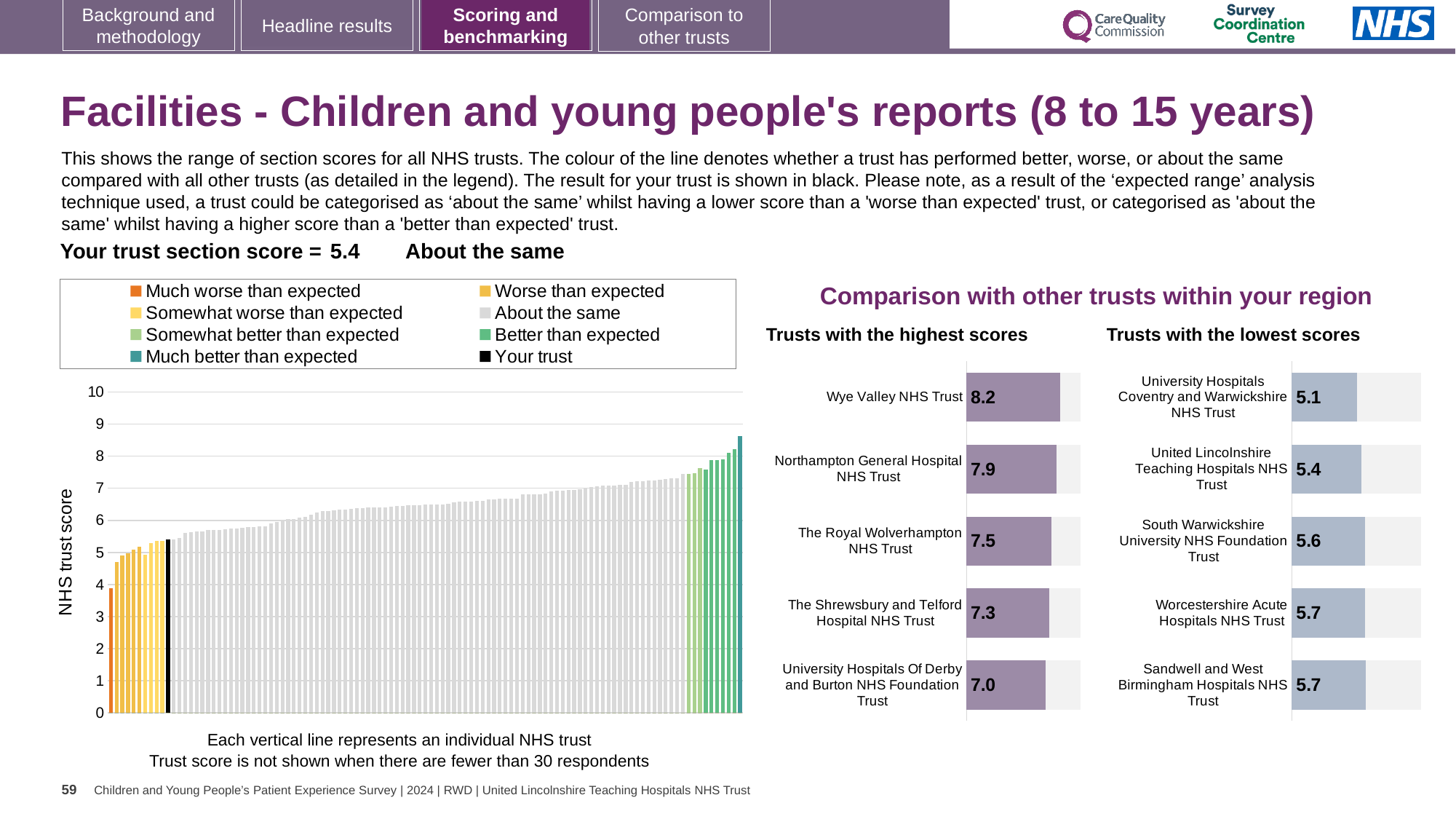
In the 'Trusts with the lowest scores' chart, what is the score for University Hospitals Coventry and Warwickshire NHS Trust? 5.1 In the 'Trusts with the highest scores' chart, which trust has the highest score? Wye Valley NHS Trust In the main 'NHS trust score' chart, what is the section score for your trust (the black bar)? 5.4 In the 'Trusts with the highest scores' chart, what is the score for The Shrewsbury and Telford Hospital NHS Trust? 7.3 How many trusts are shown in the 'Trusts with the highest scores' chart? 5 In the 'Trusts with the highest scores' chart, what is the score for Wye Valley NHS Trust? 8.2 In the 'Trusts with the highest scores' chart, what is the difference between the scores of Wye Valley NHS Trust and University Hospitals Of Derby and Burton NHS Foundation Trust? 1.2 In the main 'NHS trust score' chart, is the value of the tallest bar greater or less than 8? greater In the main 'NHS trust score' chart, do the bar values rise or fall from left to right? rise In the 'Trusts with the lowest scores' chart, which has the larger score: United Lincolnshire Teaching Hospitals NHS Trust or South Warwickshire University NHS Foundation Trust? South Warwickshire University NHS Foundation Trust How many entries does the legend of the main 'NHS trust score' chart list? 8 In the 'Trusts with the lowest scores' chart, which trust has the lowest score? University Hospitals Coventry and Warwickshire NHS Trust